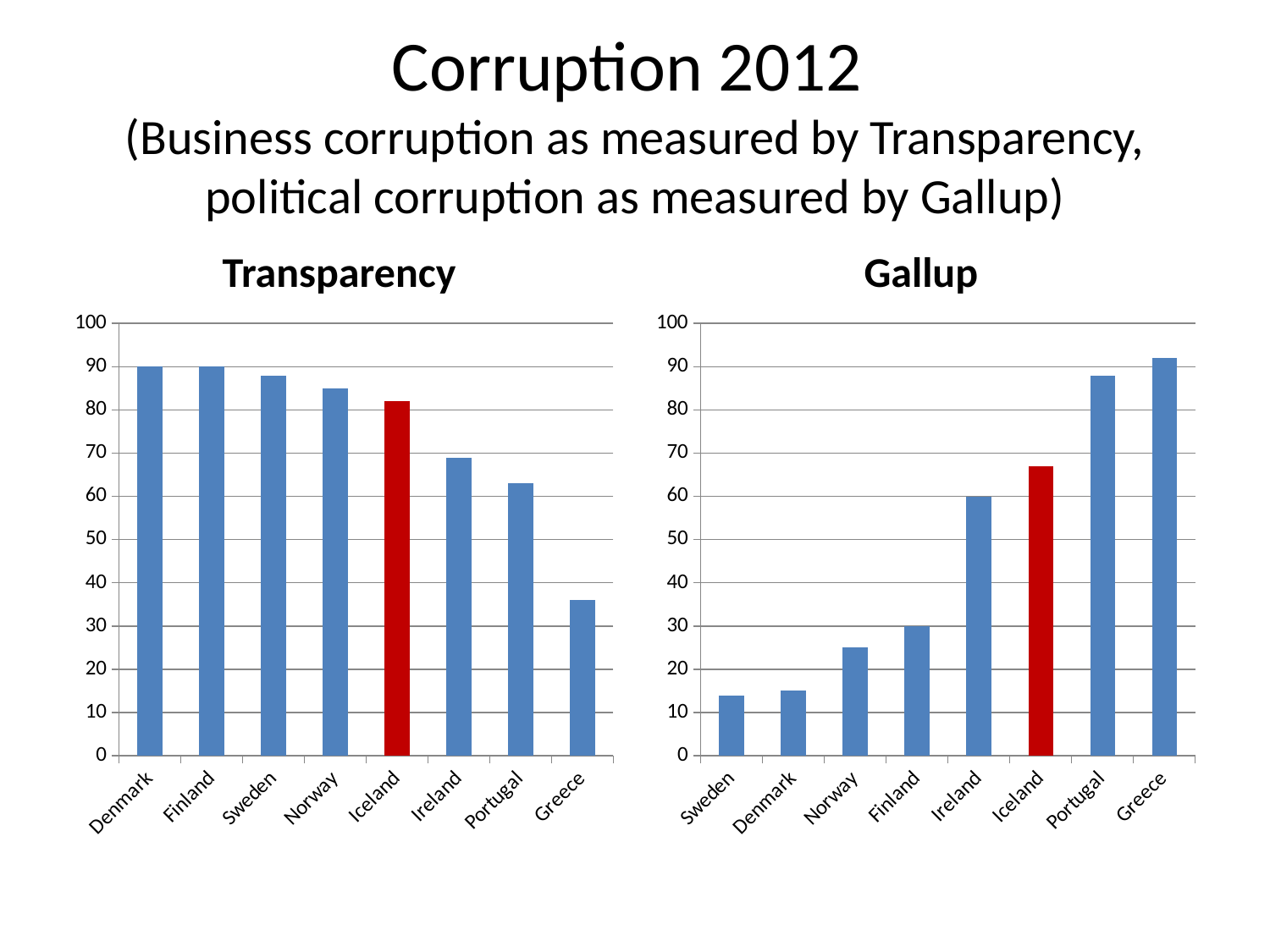
How many countries are shown on the Gallup chart? 8 On the Gallup chart, do the values generally rise or fall from left to right? rise On the Transparency chart, which country's bar is coloured red? Iceland On the Transparency chart, which country has the lowest value? Greece On the Gallup chart, which country has the highest value? Greece On the Gallup chart, is the value for Norway greater or less than 30? less On the Transparency chart, is the value for Iceland greater or less than 80? greater What kind of chart is the Transparency chart? bar chart On the Transparency chart, which is larger, the value for Ireland or the value for Portugal? Ireland On the Gallup chart, is the value for Portugal greater or less than 80? greater On the Gallup chart, which is larger, the value for Iceland or the value for Ireland? Iceland